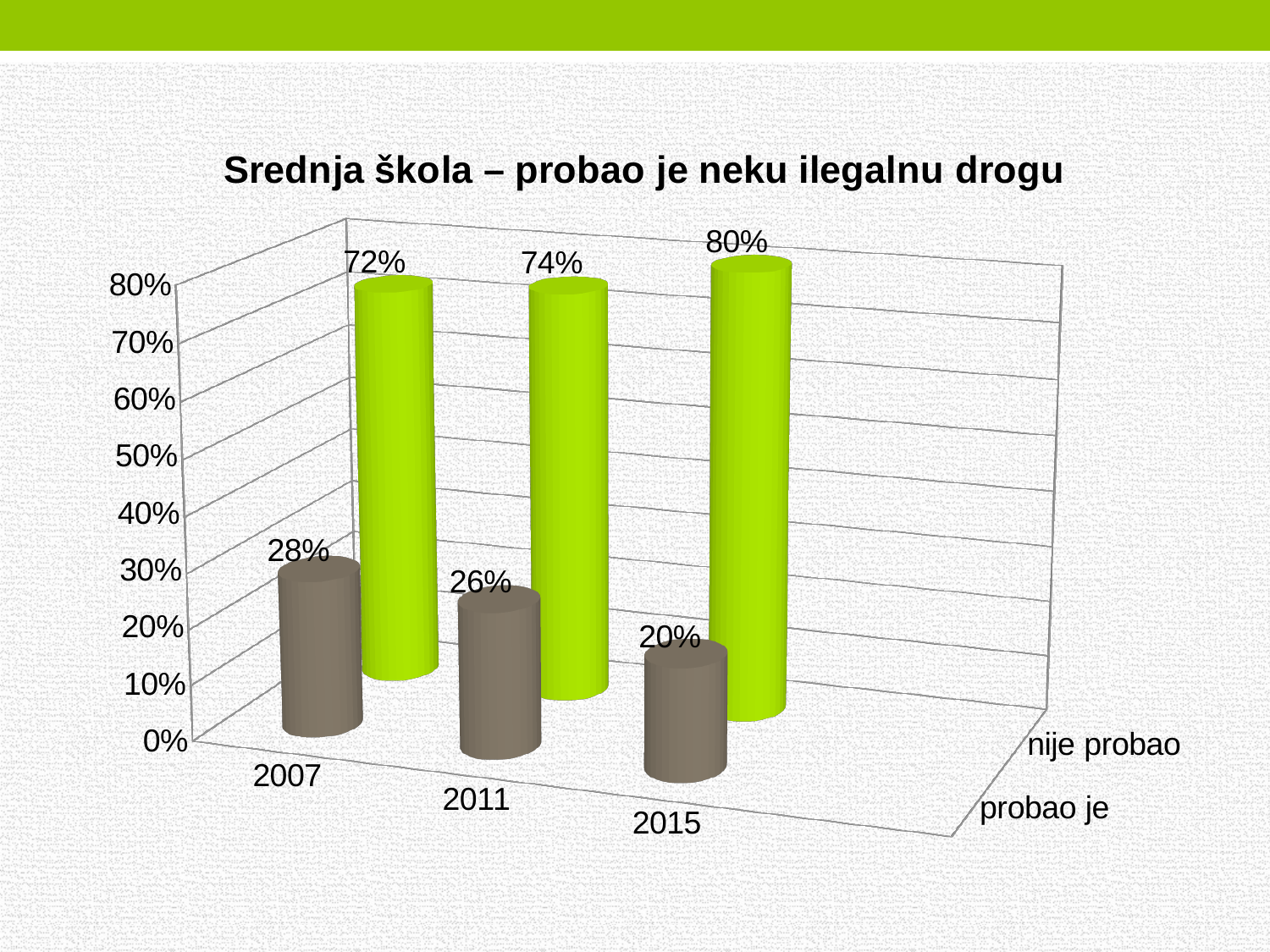
What is the difference between the "nije probao" and "probao je" values in 2007? 44% In which year is the "nije probao" value highest? 2015 What is the value for "nije probao" in 2011? 74% Which is larger in 2015: "probao je" or "nije probao"? nije probao What is the value for "probao je" in 2011? 26% How many series does the chart show? 2 In which year is the "probao je" value lowest? 2015 Do the "probao je" values rise or fall from 2007 to 2015? fall What is the value for "nije probao" in 2015? 80% What is the value for "probao je" in 2007? 28% What kind of chart is this? bar chart How many years are shown on the x axis? 3